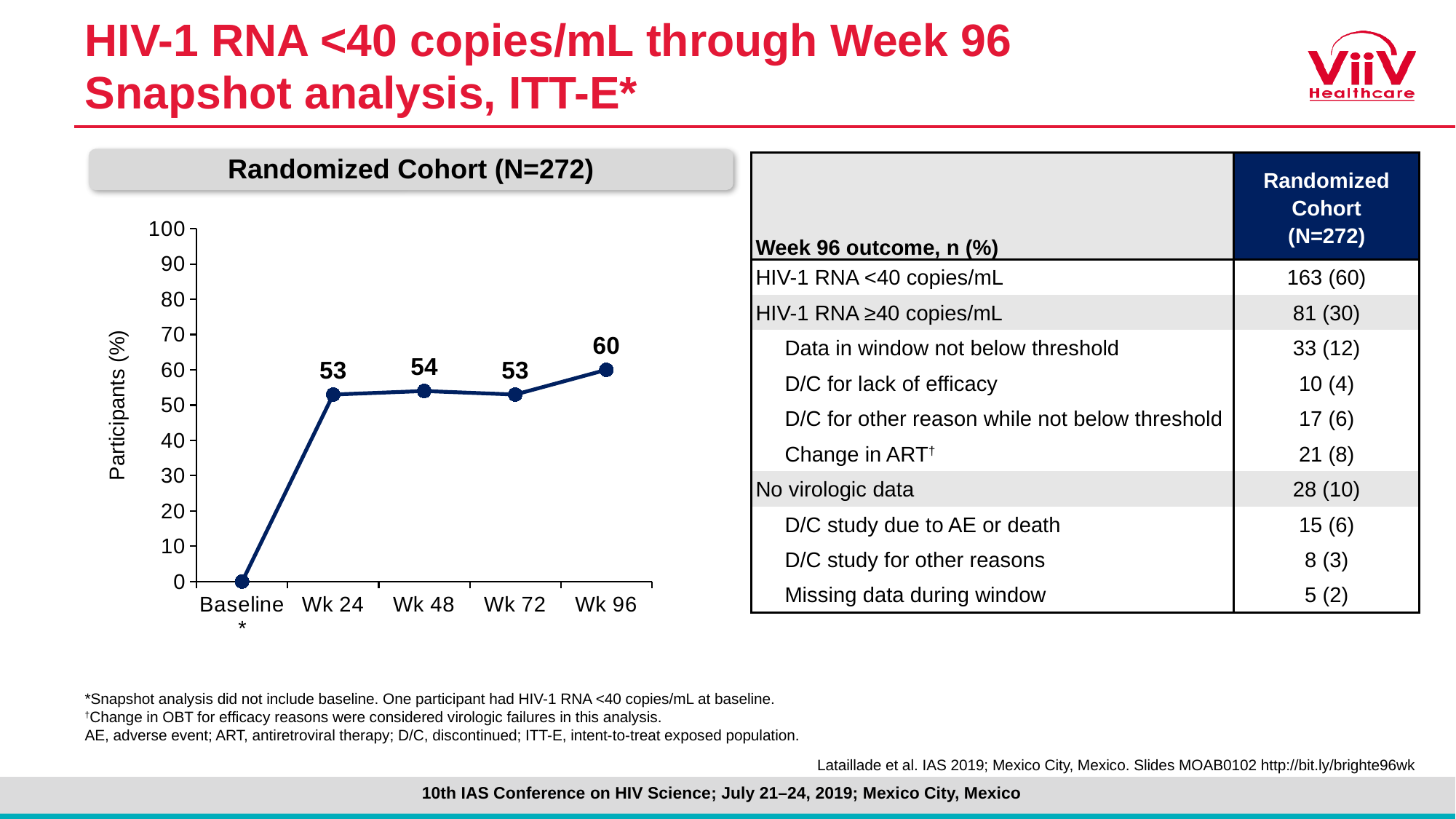
How many time points are plotted on the chart? 5 Which is larger, the value at Wk 48 or the value at Wk 96? Wk 96 Which time point has the highest value? Wk 96 What is the difference between the values at Wk 96 and Wk 72? 7 Is the value for Wk 96 greater or less than 50? greater What is the value at Baseline? 0 What is the label of the y axis? Participants (%) What kind of chart is shown on the slide? line chart Which time point has the lowest value? Baseline What is the value for Wk 96? 60 What is the value for Wk 48? 54 What is the value for Wk 24? 53